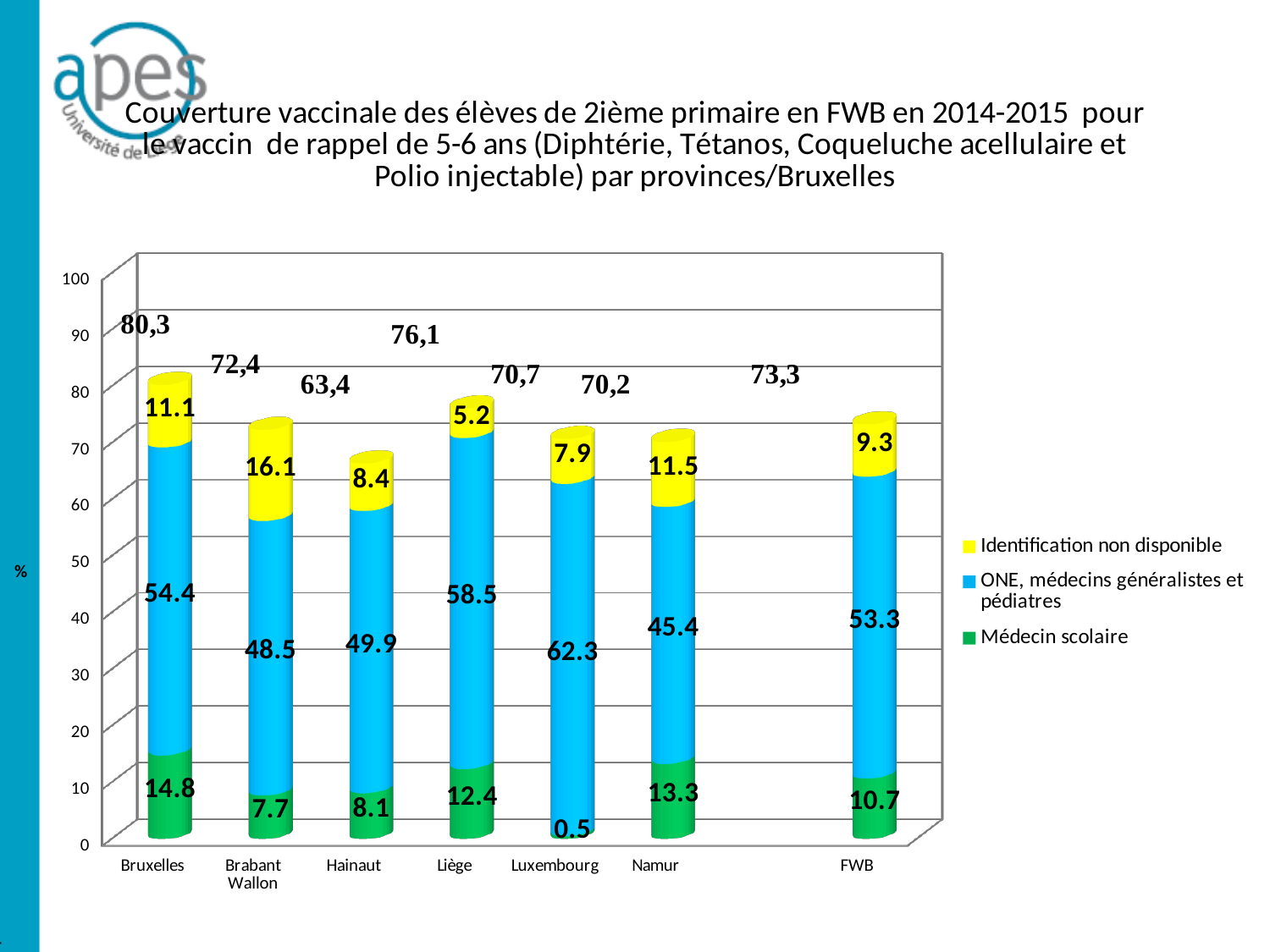
Which is larger for ONE, médecins généralistes et pédiatres: Liège or FWB? Liège What is the value for ONE, médecins généralistes et pédiatres in Luxembourg? 62.3 How many categories are shown on the x axis? 7 What total coverage is printed above the Liège bar? 76,1 What is the difference between the Médecin scolaire values for Bruxelles and Namur? 1.5 What kind of chart is shown on the slide? Stacked bar chart Which category has the lowest value for Identification non disponible? Liège How many series does the legend list? 3 What is the value for Identification non disponible in Brabant Wallon? 16.1 Which category has the lowest value for Médecin scolaire? Luxembourg What is the value for Médecin scolaire in Bruxelles? 14.8 Which category has the highest value for Médecin scolaire? Bruxelles